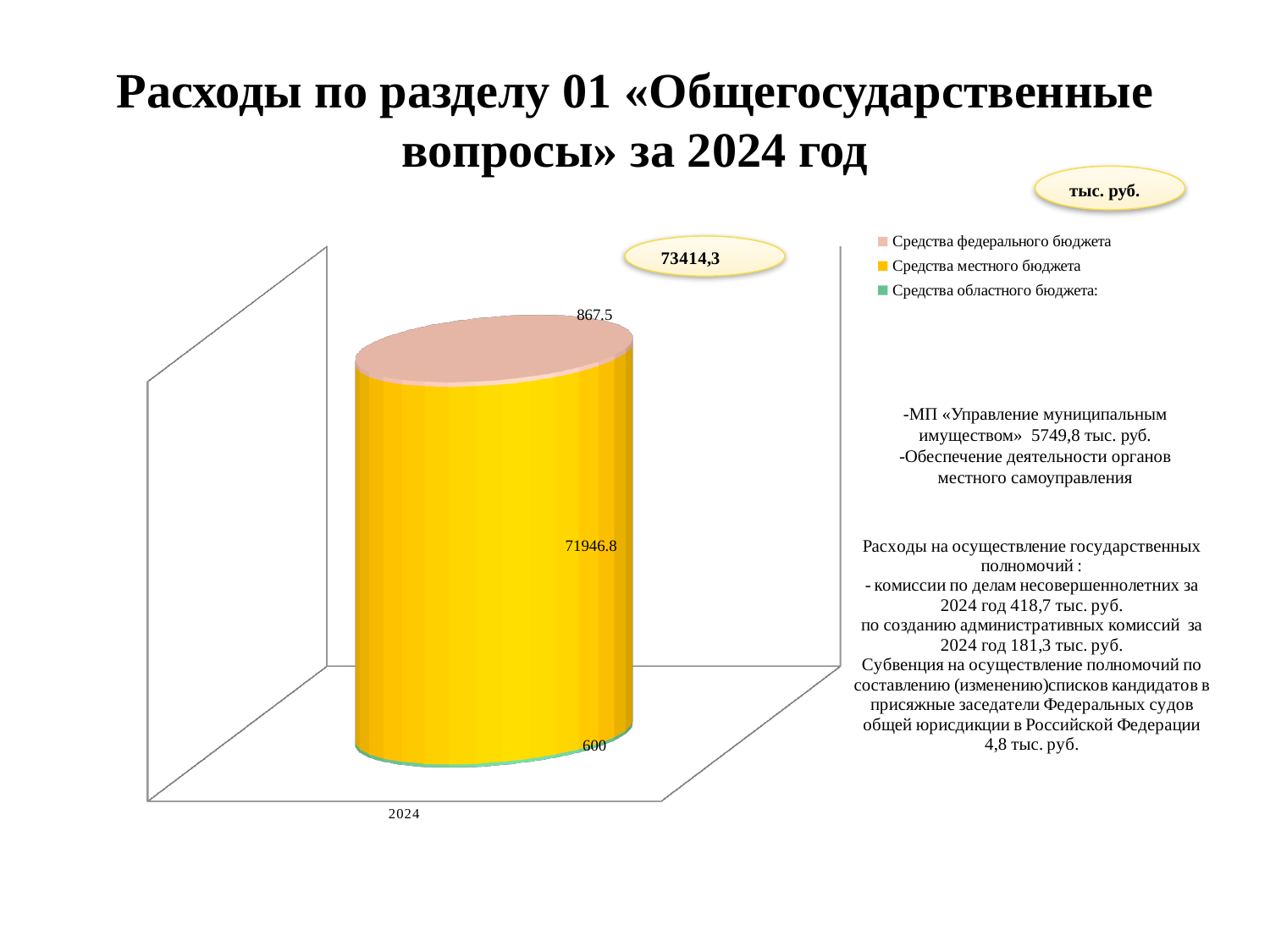
How many categories are shown on the x axis of the chart? 1 Which is larger: the value for Средства федерального бюджета or the value for Средства областного бюджета? Средства федерального бюджета What kind of chart is shown on the slide? Stacked bar chart What is the total of the stacked bar for 2024? 73414,3 What is the difference between the values for Средства местного бюджета and Средства федерального бюджета? 71079.3 How many series does the legend list? 3 What is the value for Средства местного бюджета in the chart? 71946.8 Which series has the highest value in the chart? Средства местного бюджета What is the value for Средства федерального бюджета in the chart? 867.5 What is the difference between the values for Средства федерального бюджета and Средства областного бюджета? 267.5 Which series has the lowest value in the chart? Средства областного бюджета What is the value for Средства областного бюджета in the chart? 600